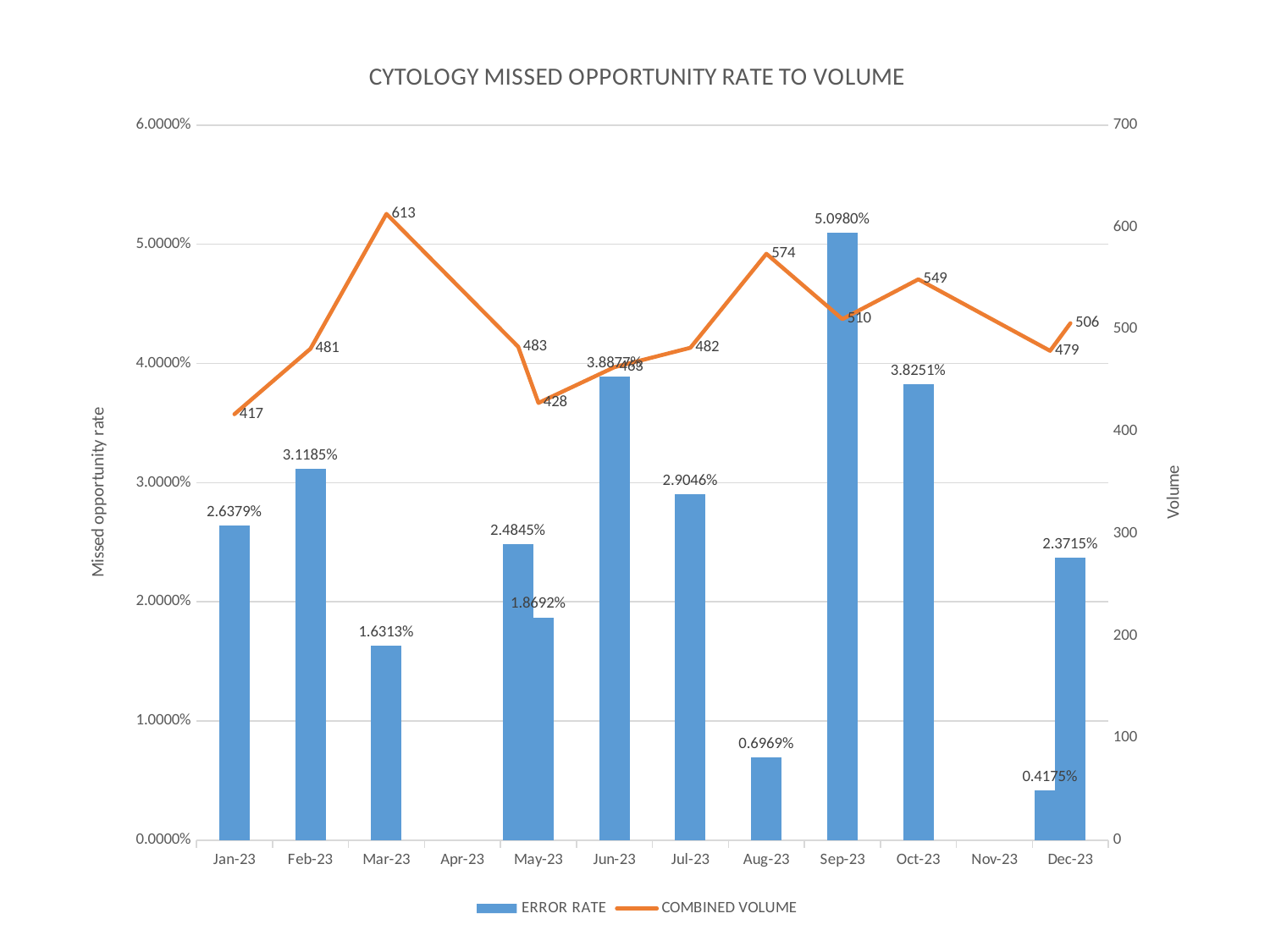
What is the difference between the error rates for Sep-23 and Oct-23? 1.2729% Which month has the highest error rate? Sep-23 What is the error rate for Aug-23? 0.6969% What is the title of the chart? CYTOLOGY MISSED OPPORTUNITY RATE TO VOLUME How many series does the legend list? 2 What is the difference between the combined volume for Mar-23 and Jan-23? 196 Which has the higher error rate, Feb-23 or Jul-23? Feb-23 What is the combined volume for Mar-23? 613 What is the error rate for Sep-23? 5.0980% Which month has the highest combined volume? Mar-23 What is the combined volume for Jan-23? 417 What is the error rate for Feb-23? 3.1185%